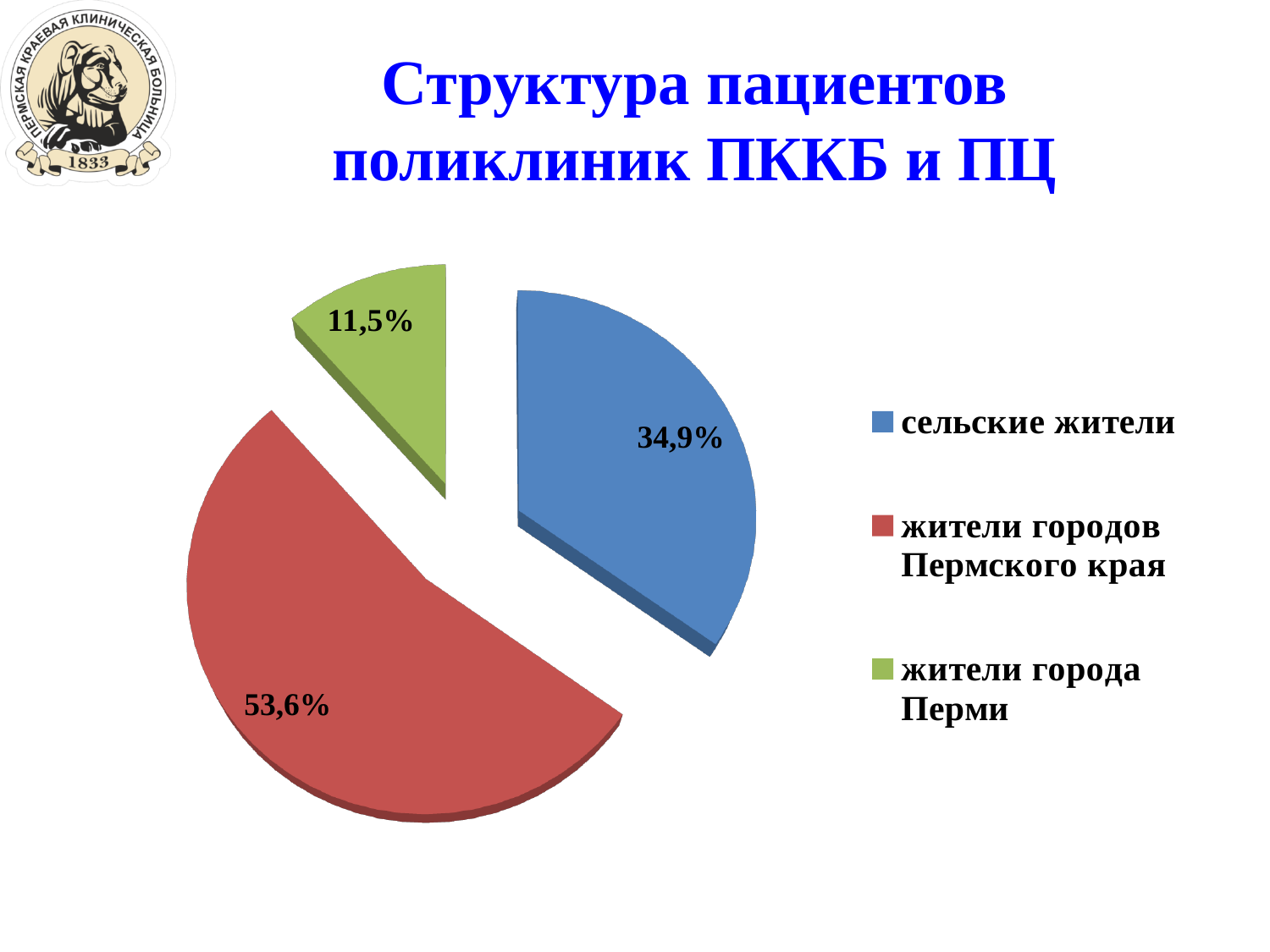
What share of patients are жители городов Пермского края? 53,6% What colour is the slice for жители городов Пермского края? red Which category has the smallest share of patients? жители города Перми What share of patients are сельские жители? 34,9% Which is larger: the share of сельские жители or the share of жители города Перми? сельские жители What is the title of the slide? Структура пациентов поликлиник ПККБ и ПЦ What is the difference in percentage points between сельские жители and жители города Перми? 23,4 What share of patients are жители города Перми? 11,5% Which category has the largest share of patients? жители городов Пермского края How many categories does the pie chart show? 3 What is the difference in percentage points between жители городов Пермского края and сельские жители? 18,7 What kind of chart is shown on the slide? pie chart